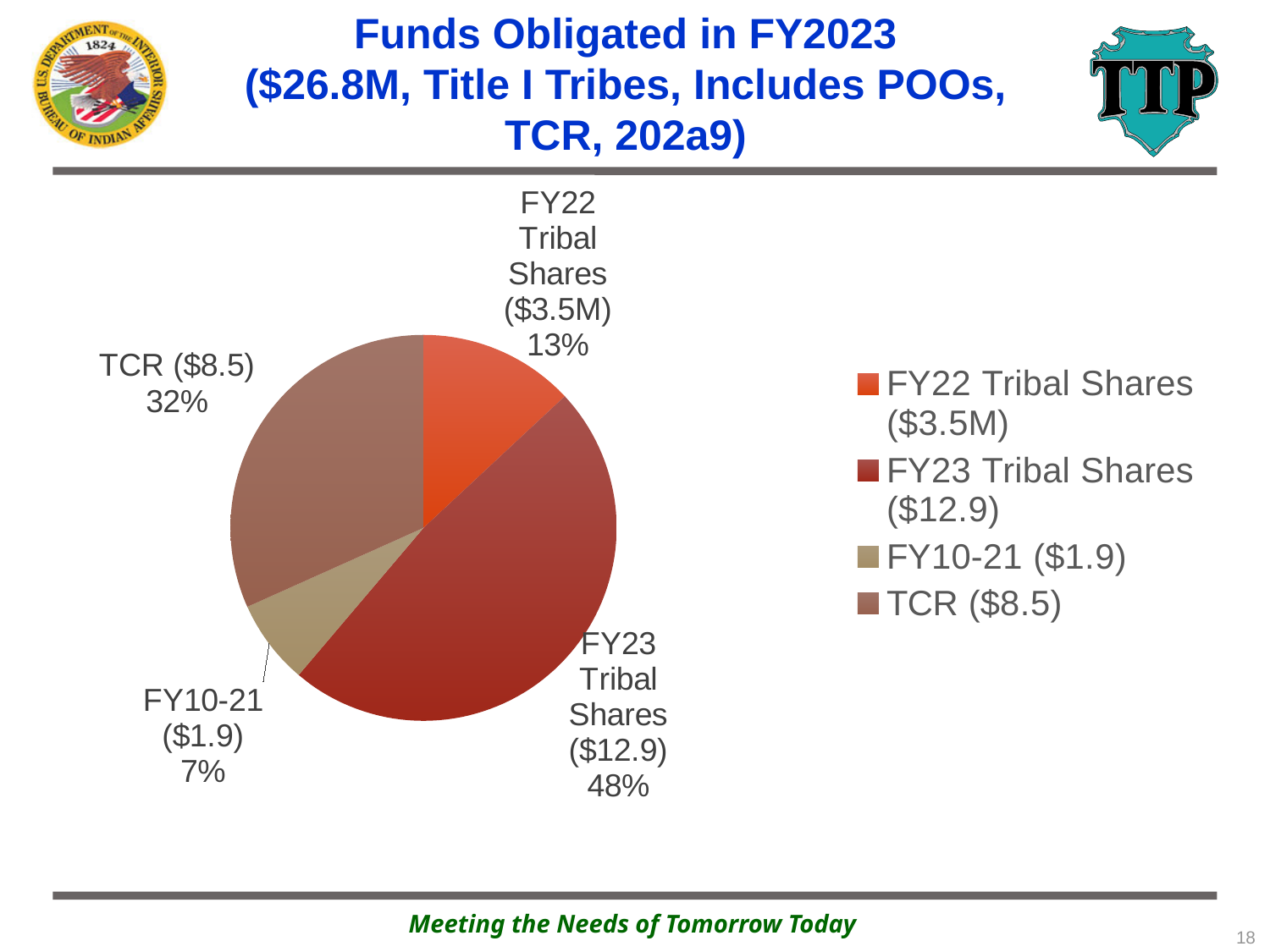
Which is larger, the TCR slice or the FY22 Tribal Shares slice? TCR ($8.5) What percentage share does the FY22 Tribal Shares slice have? 13% Which slice of the pie is the largest? FY23 Tribal Shares ($12.9) How many slices does the pie chart have? 4 What percentage share does the TCR slice have? 32% What kind of chart is shown on the slide? pie chart What dollar amount is shown for the TCR slice? $8.5 What percentage share does the FY23 Tribal Shares slice have? 48% What is the difference in percentage points between the FY23 Tribal Shares slice and the TCR slice? 16% What is the title of the chart on the slide? Funds Obligated in FY2023 ($26.8M, Title I Tribes, Includes POOs, TCR, 202a9) Which slice of the pie is the smallest? FY10-21 ($1.9)